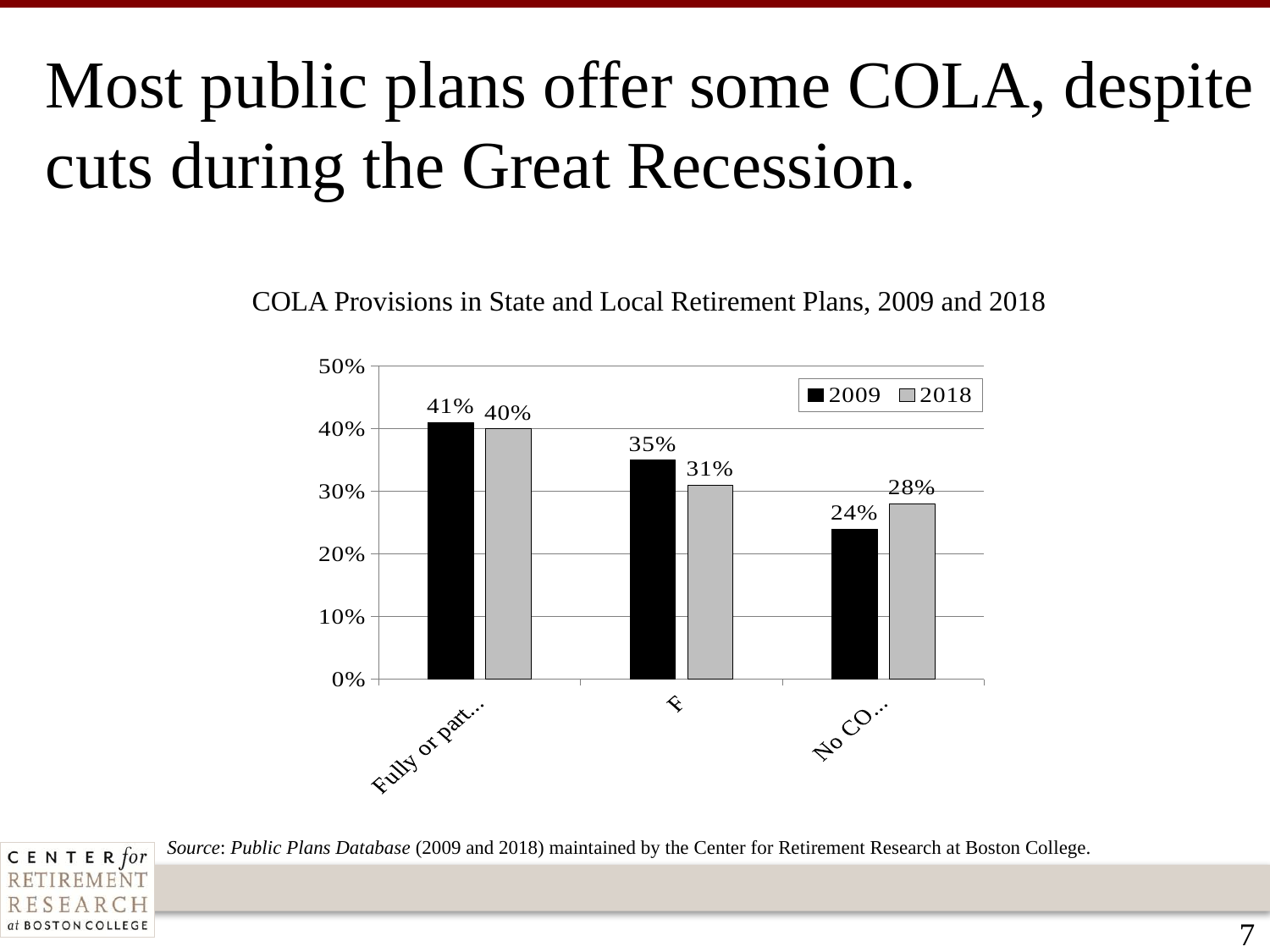
What is the 2009 value for the first category (labelled 'Fully or part...')? 41% What is the title of the chart? COLA Provisions in State and Local Retirement Plans, 2009 and 2018 What is the difference between the 2009 and 2018 values for the middle category? 4 percentage points Which category has the lowest 2009 value? No CO... (the third category) What is the 2018 value for the third category (labelled 'No CO...')? 28% What is the 2018 value for the first category (labelled 'Fully or part...')? 40% What is the 2009 value for the middle category? 35% For the third category (labelled 'No CO...'), which is larger, the 2009 value or the 2018 value? 2018 How many groups of bars (categories) are shown on the x axis? 3 What type of chart is shown on the slide? bar chart How many series does the legend list? 2 Which series is shown in black bars? 2009